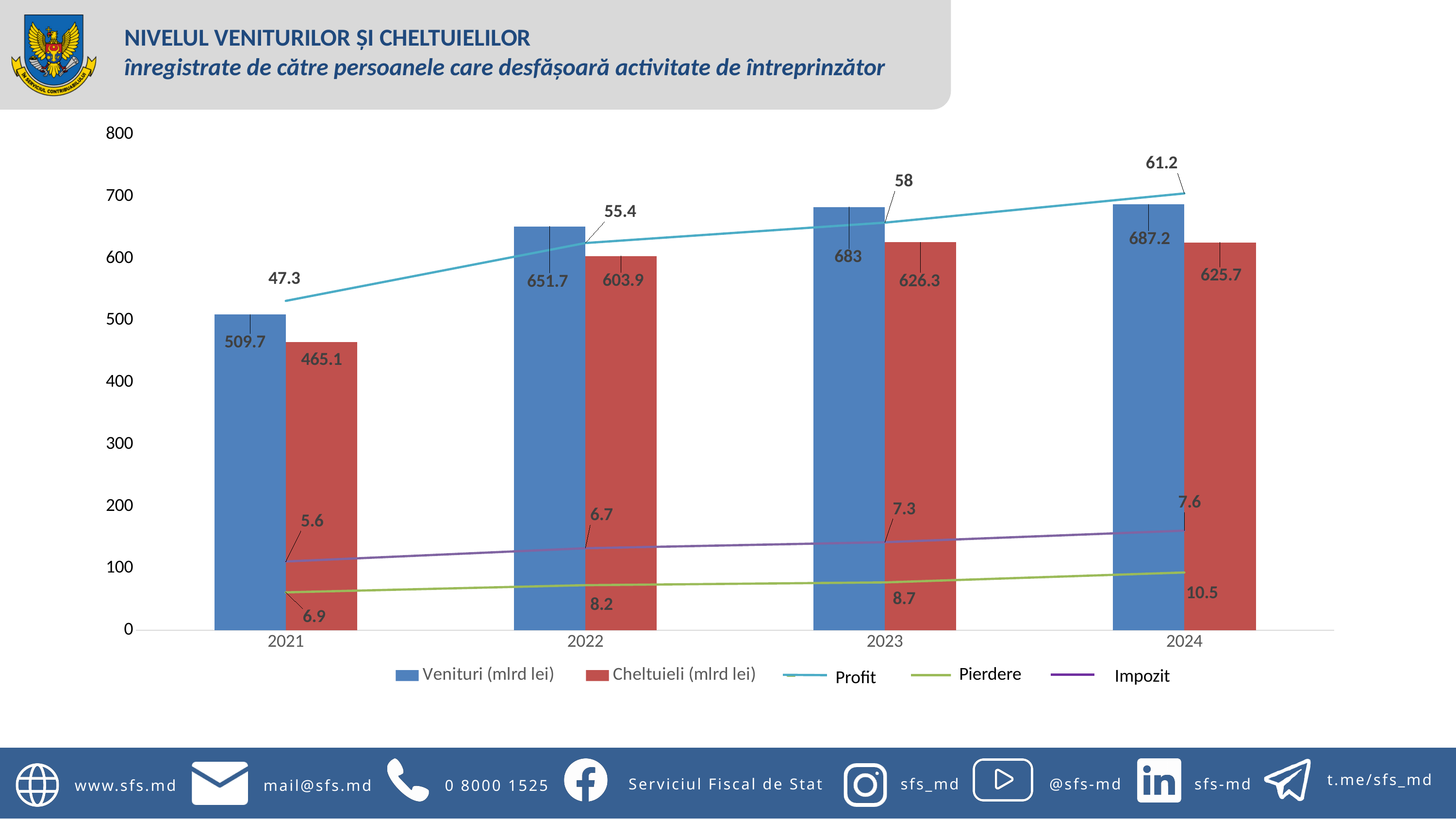
What is the value of Cheltuieli (mlrd lei) for 2021? 465.1 What is the Pierdere value shown for 2023? 8.7 Which is larger in 2024: Venituri or Cheltuieli? Venituri In which year is Venituri (mlrd lei) highest? 2024 What is the Impozit value shown for 2022? 6.7 Does the Profit line rise or fall from 2021 to 2024? rise What is the difference between Venituri and Cheltuieli in 2022? 47.8 What is the value of Venituri (mlrd lei) for 2023? 683 In which year is Cheltuieli (mlrd lei) lowest? 2021 What is the Profit value shown for 2024? 61.2 How many years are shown on the x axis? 4 How many series does the legend list? 5